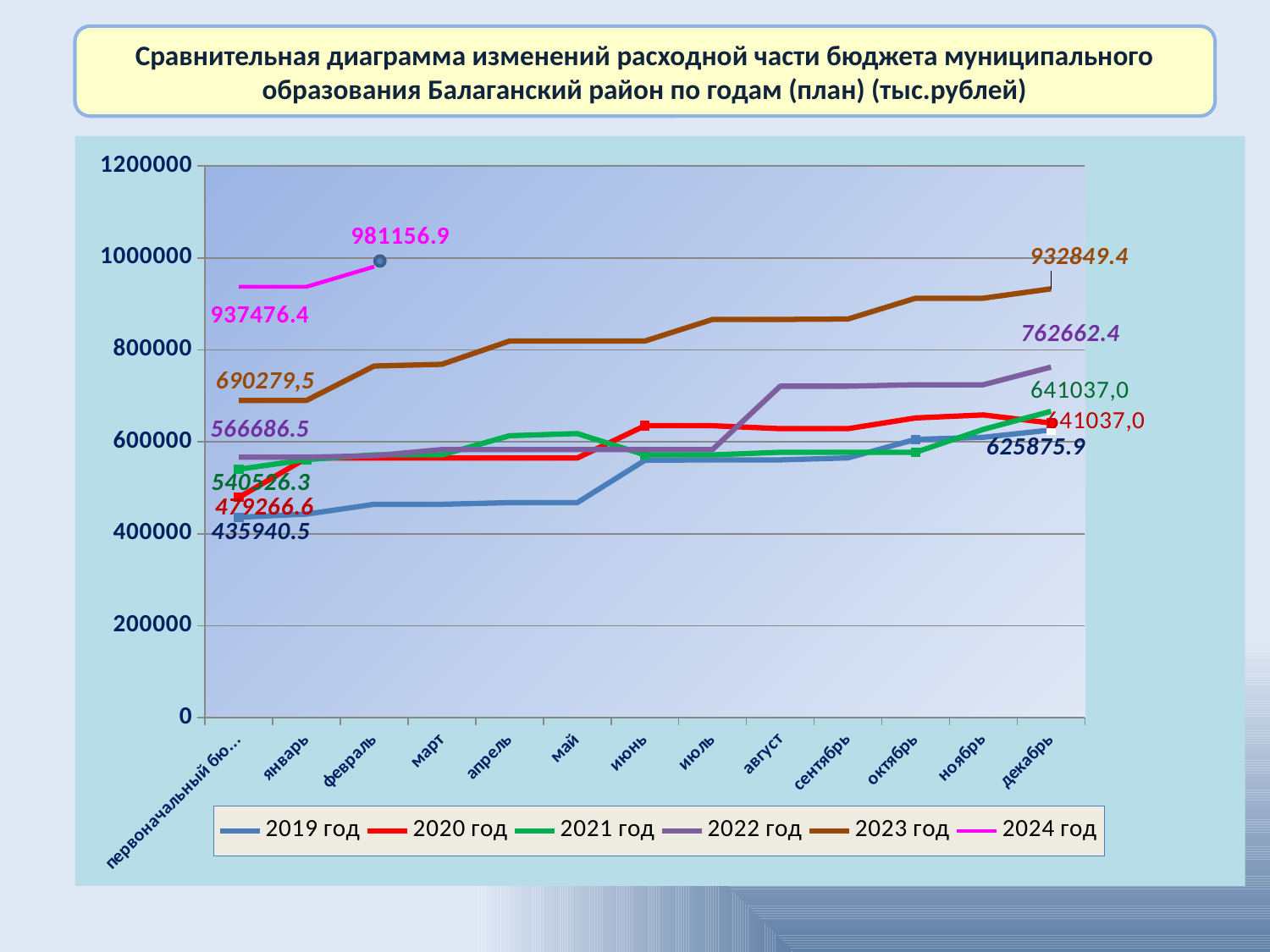
What kind of chart is shown on the slide? line chart Is the value of the 2023 год series at август greater or less than 800000? greater How many series does the legend list? 6 What is the value of the 2022 год series at декабрь? 762662.4 Does the 2023 год series rise or fall from первоначальный бюджет to декабрь? rise What is the value of the 2019 год series at декабрь? 625875.9 What is the value of the 2024 год series at февраль? 981156.9 What is the first labelled value of the 2020 год series (at первоначальный бюджет)? 479266.6 Which series has the highest value at декабрь? 2023 год Which is larger: the 2022 год value at декабрь or the 2021 год value at декабрь? 2022 год Which series has the lowest value at первоначальный бюджет? 2019 год What is the value of the 2023 год series at декабрь? 932849.4